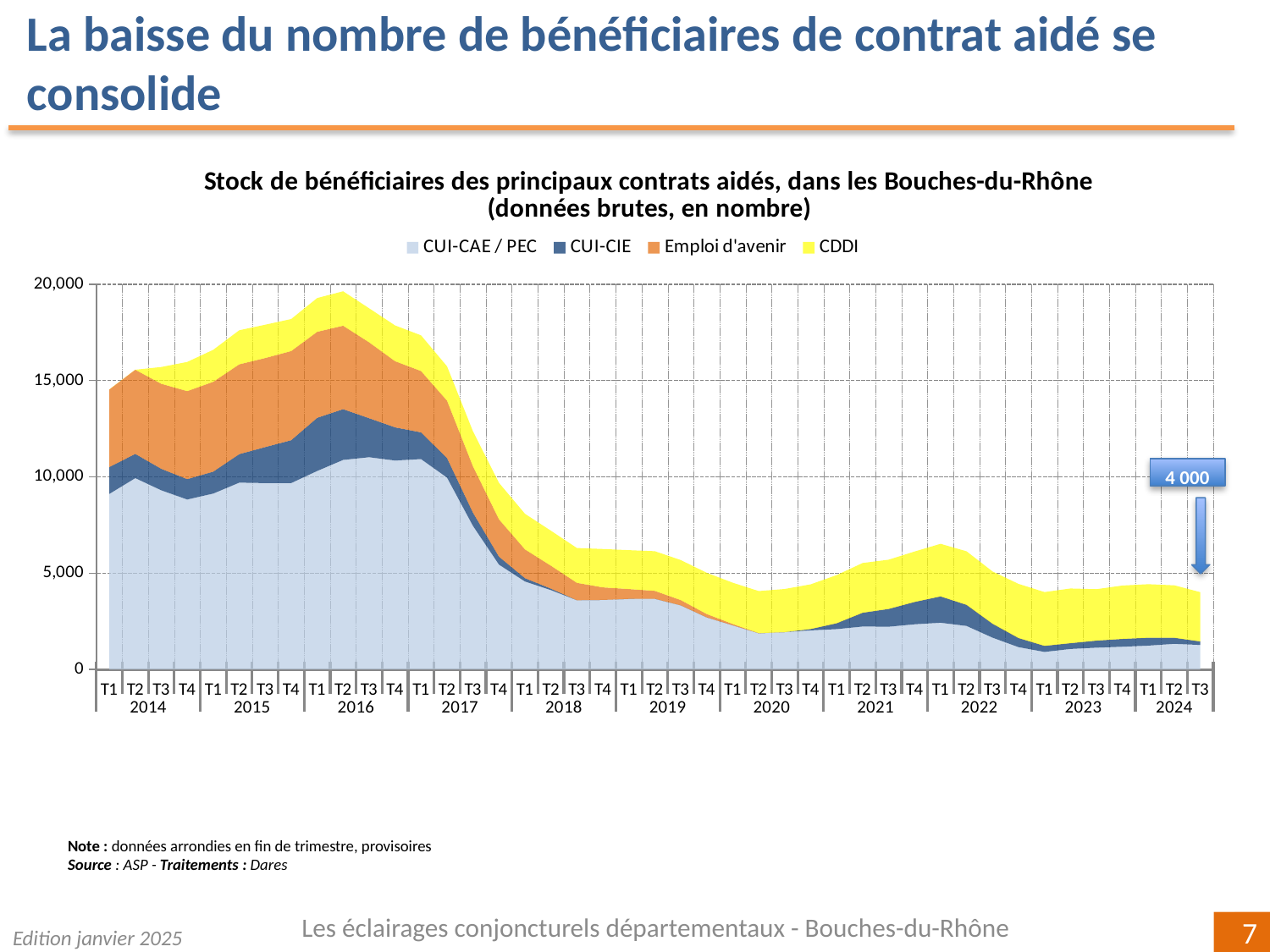
Does the total stock of beneficiaries rise or fall between 2016 and 2020? Fall Is the total stock of beneficiaries in T1 2014 greater or less than 10,000? greater Which is larger, the total stock in T2 2016 or in T3 2024? T2 2016 In which year does the total stock of beneficiaries reach its highest level? 2016 Is the total stock of beneficiaries in T2 2016 greater or less than 15,000? greater What value does the callout annotation at the right end of the chart show for T3 2024? 4 000 How many series does the legend list? 4 What is the title of the chart? Stock de bénéficiaires des principaux contrats aidés, dans les Bouches-du-Rhône (données brutes, en nombre) Which series is shown in yellow? CDDI Is the total stock of beneficiaries in T3 2024 greater or less than 5,000? less What kind of chart is shown on the slide? Stacked area chart